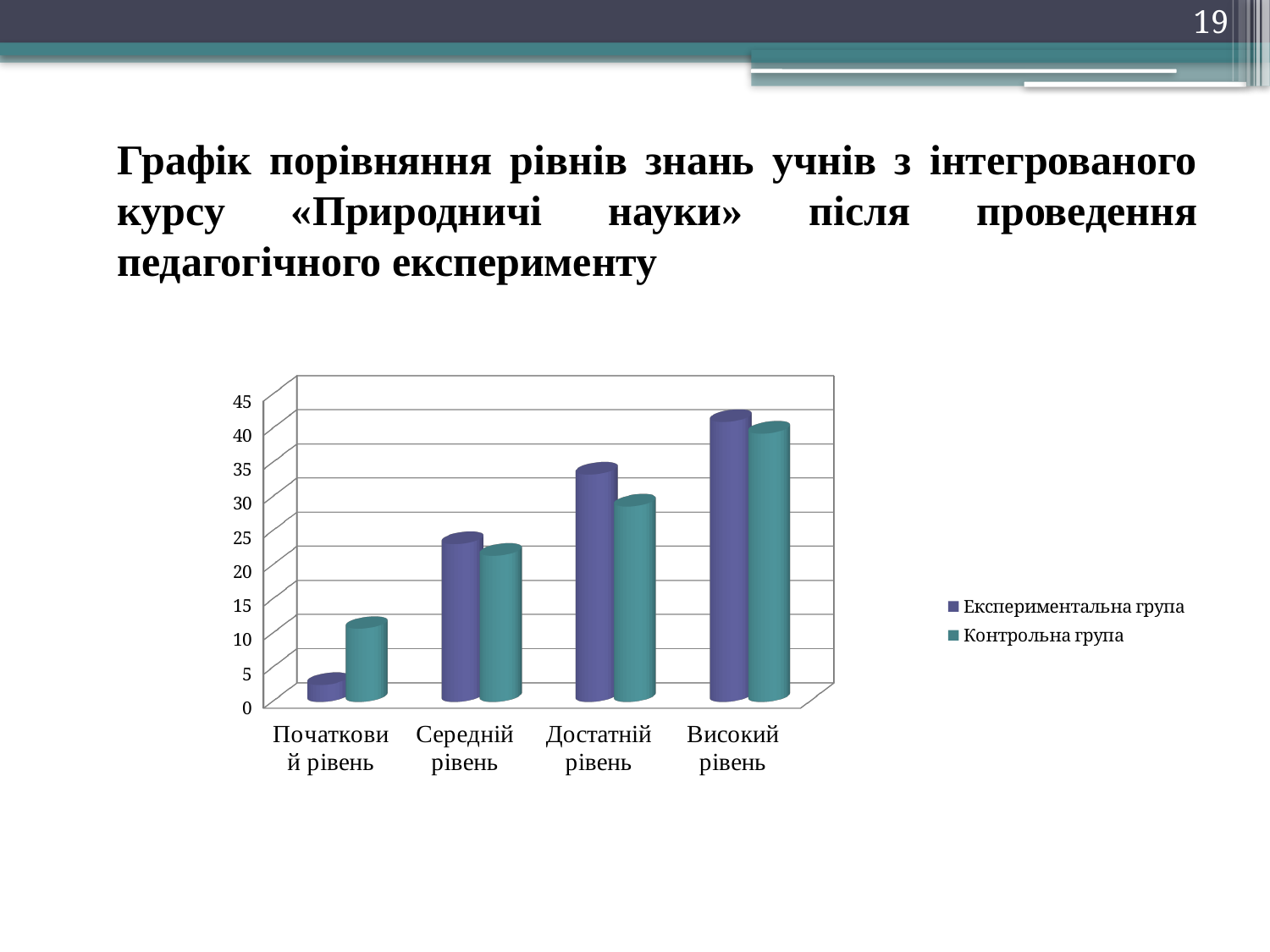
For Достатній рівень, which series has the larger value, Експериментальна група or Контрольна група? Експериментальна група How many series does the legend list? 2 Is the value for Експериментальна група at Високий рівень greater or less than 35? greater Which category has the lowest value for Контрольна група? Початковий рівень Is the value for Експериментальна група at Початковий рівень greater or less than 5? less How many categories are shown on the x axis? 4 Which category has the lowest value for Експериментальна група? Початковий рівень Do the values for Контрольна група rise or fall from Початковий рівень to Високий рівень? rise Which category has the highest value for Експериментальна група? Високий рівень For Початковий рівень, which series has the larger value, Експериментальна група or Контрольна група? Контрольна група What kind of chart is shown on the slide? bar chart Which series is shown in purple in the legend? Експериментальна група